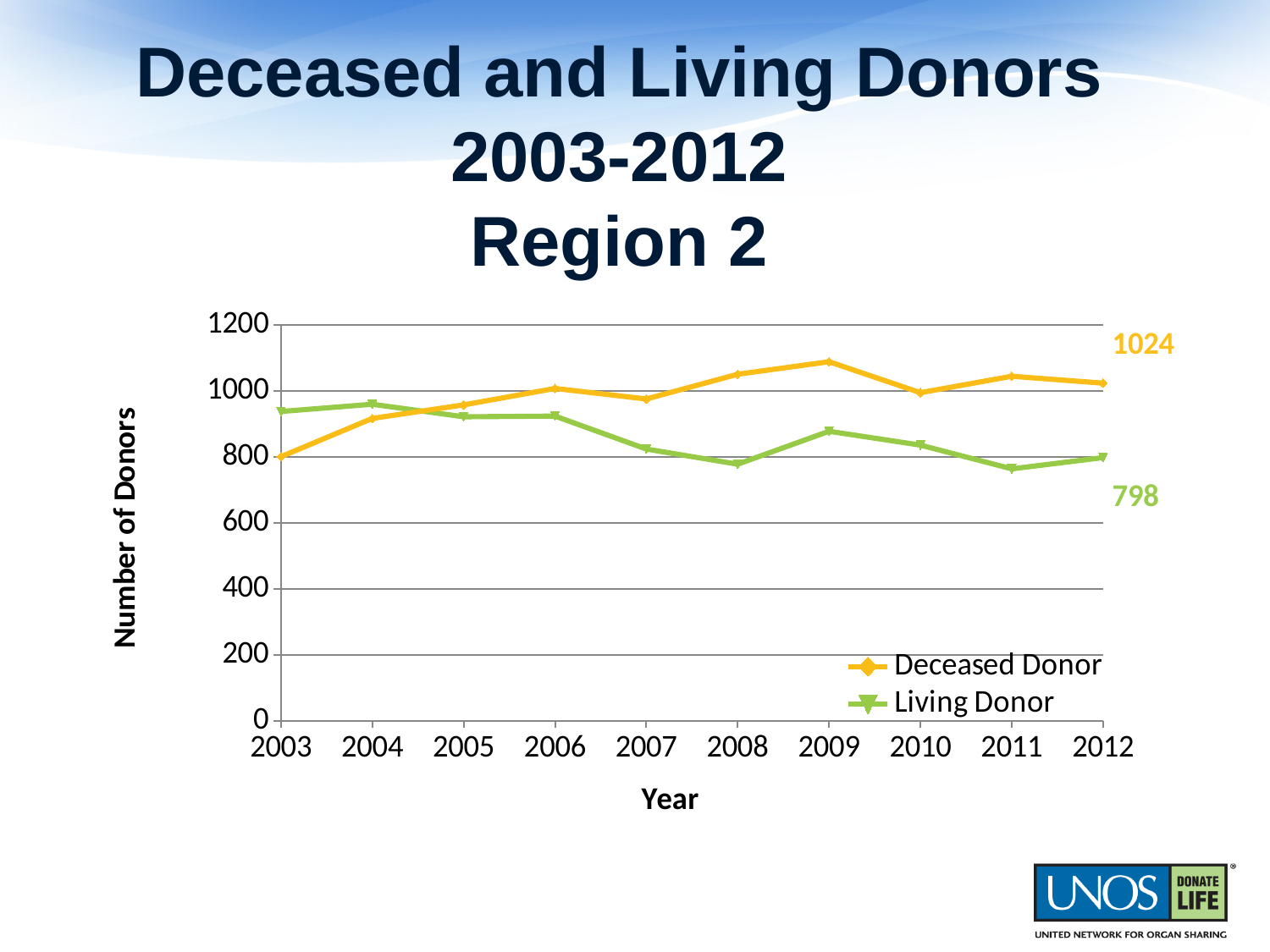
What is the difference between the Deceased Donor and Living Donor values in 2012? 226 Does the Deceased Donor series rise or fall from 2003 to 2009? rise Is the value for Living Donor in 2004 greater or less than 800? greater How many years are shown on the x axis? 10 In 2012, which series has the larger value, Deceased Donor or Living Donor? Deceased Donor What is the value for Living Donor in 2012? 798 Is the value for Deceased Donor in 2003 greater or less than 1000? less Is the value for Deceased Donor in 2009 greater or less than 1000? greater Which colour is used for the Living Donor series? green How many series does the legend list? 2 What is the value for Deceased Donor in 2012? 1024 What kind of chart is shown on the slide? line chart